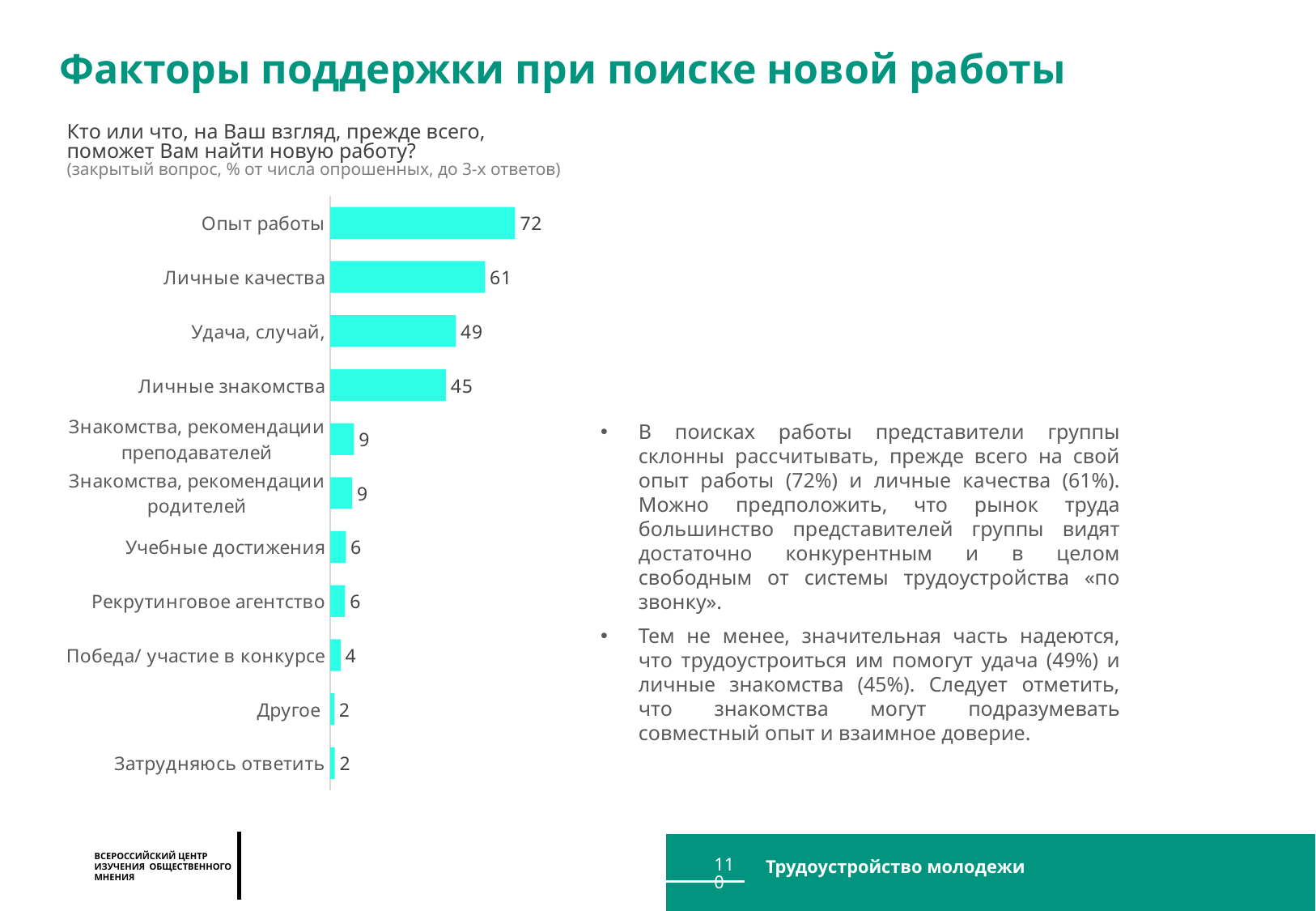
How many categories are shown in the chart? 11 Which is larger, the value for Удача, случай, or the value for Личные знакомства? Удача, случай, What is the value for Личные знакомства? 45 What is the difference between the values for Опыт работы and Личные качества? 11 What is the value for Учебные достижения? 6 What is the value for Знакомства, рекомендации родителей? 9 What is the value for Опыт работы? 72 What kind of chart is shown on the slide? bar chart What is the difference between the values for Личные качества and Удача, случай,? 12 What is the value for Победа/ участие в конкурсе? 4 Which category has the highest value? Опыт работы What is the title of the slide? Факторы поддержки при поиске новой работы